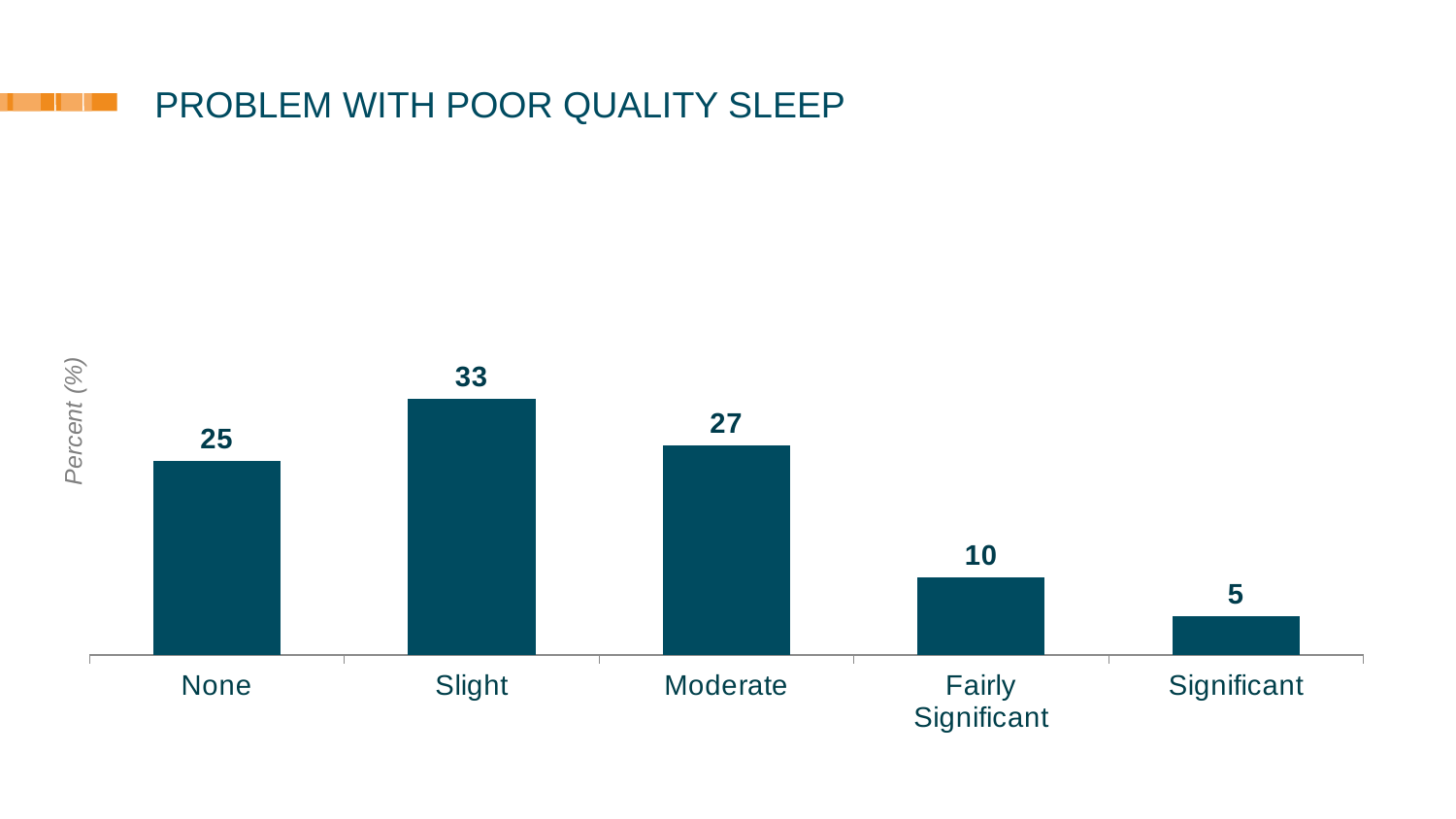
Which category has the lowest value? Significant What kind of chart is shown on the slide? Bar chart What is the value for Fairly Significant? 10 How many categories are shown on the x axis? 5 What is the value for None? 25 What is the title of the chart? PROBLEM WITH POOR QUALITY SLEEP What is the difference between the values for Slight and Moderate? 6 Which category has the highest value? Slight What is the label of the y axis? Percent (%) What is the difference between the values for None and Significant? 20 Which is larger, the value for Moderate or the value for None? Moderate What is the value for Slight? 33